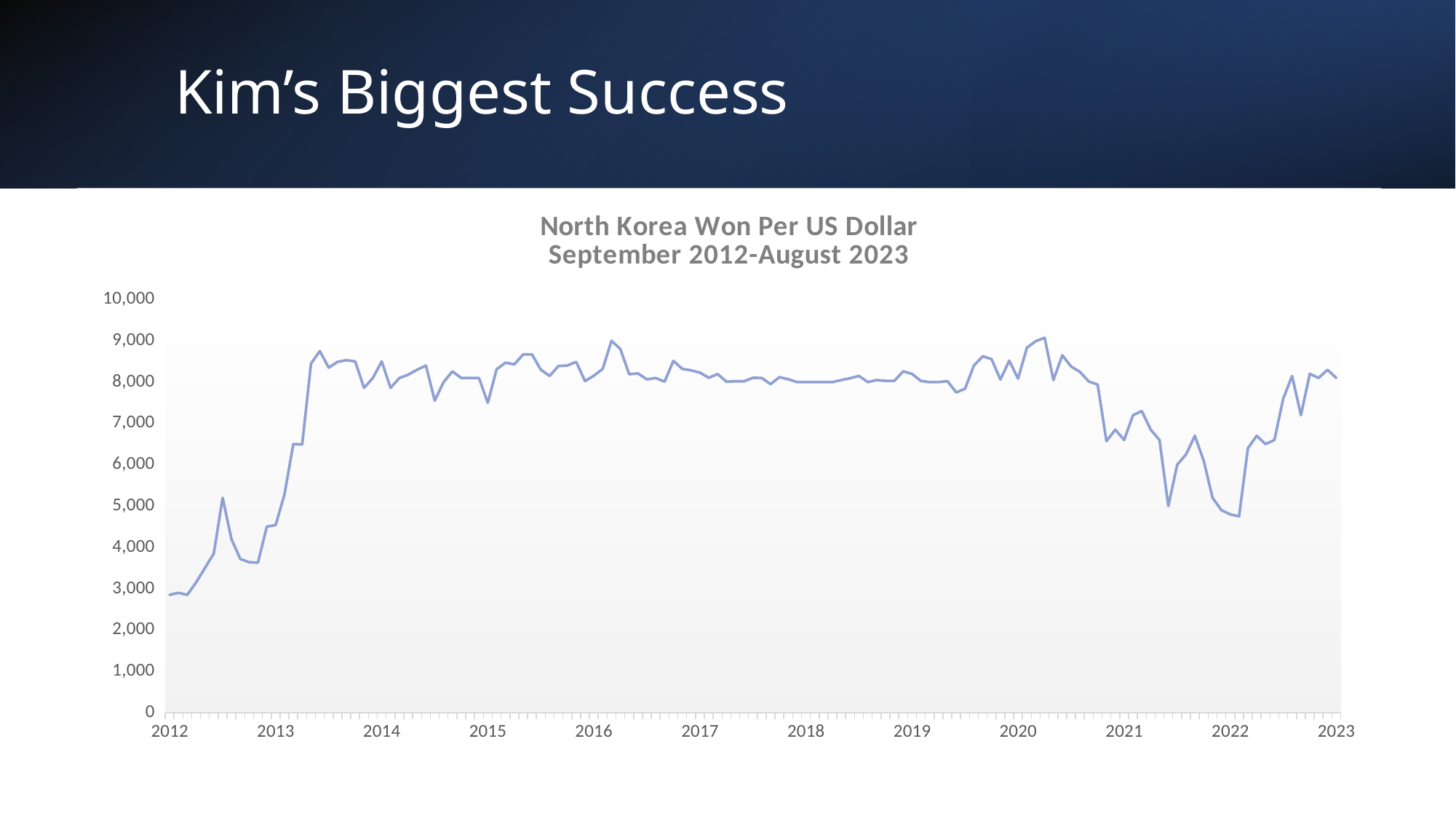
What kind of chart is shown on the slide? line chart Which is larger, the value at the 2012 tick or the value at the 2018 tick? 2018 Is the value at the 2016 tick greater or less than 7,000? greater Is the value at the start of the line in 2012 greater or less than 4,000? less Is the value at the 2018 tick greater or less than 7,000? greater What is the highest value shown on the vertical axis? 10,000 What is the title of the chart? North Korea Won Per US Dollar September 2012-August 2023 How many year labels are shown along the x axis? 12 In which year does the line reach its lowest value? 2012 Does the line rise or fall between 2020 and 2021? fall Does the line rise or fall between 2012 and 2013? rise